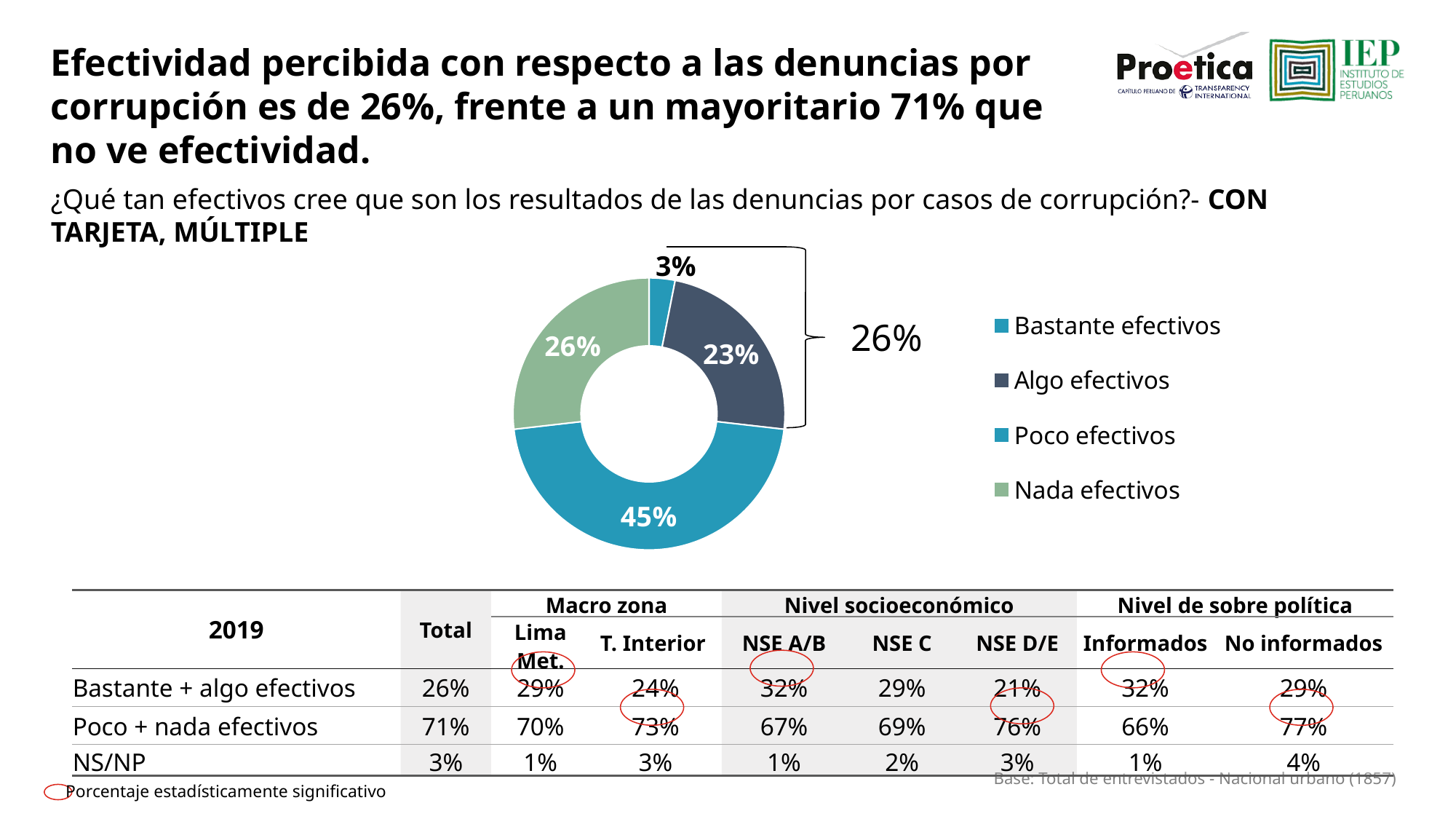
What kind of chart is shown on the slide? Pie chart (donut) Which is larger, the share for "Algo efectivos" or the share for "Nada efectivos"? Nada efectivos Which category has the smallest share of the pie? Bastante efectivos How many entries does the legend list? 4 How many categories does the pie chart show? 4 What percentage of respondents answered "Poco efectivos"? 45% What percentage of respondents answered "Nada efectivos"? 26% What combined percentage does the bracket next to the pie chart indicate for "Bastante efectivos" plus "Algo efectivos"? 26% What percentage of respondents answered "Bastante efectivos"? 3% Which category has the largest share of the pie? Poco efectivos What is the difference between the shares for "Poco efectivos" and "Nada efectivos"? 19 percentage points What percentage of respondents answered "Algo efectivos"? 23%